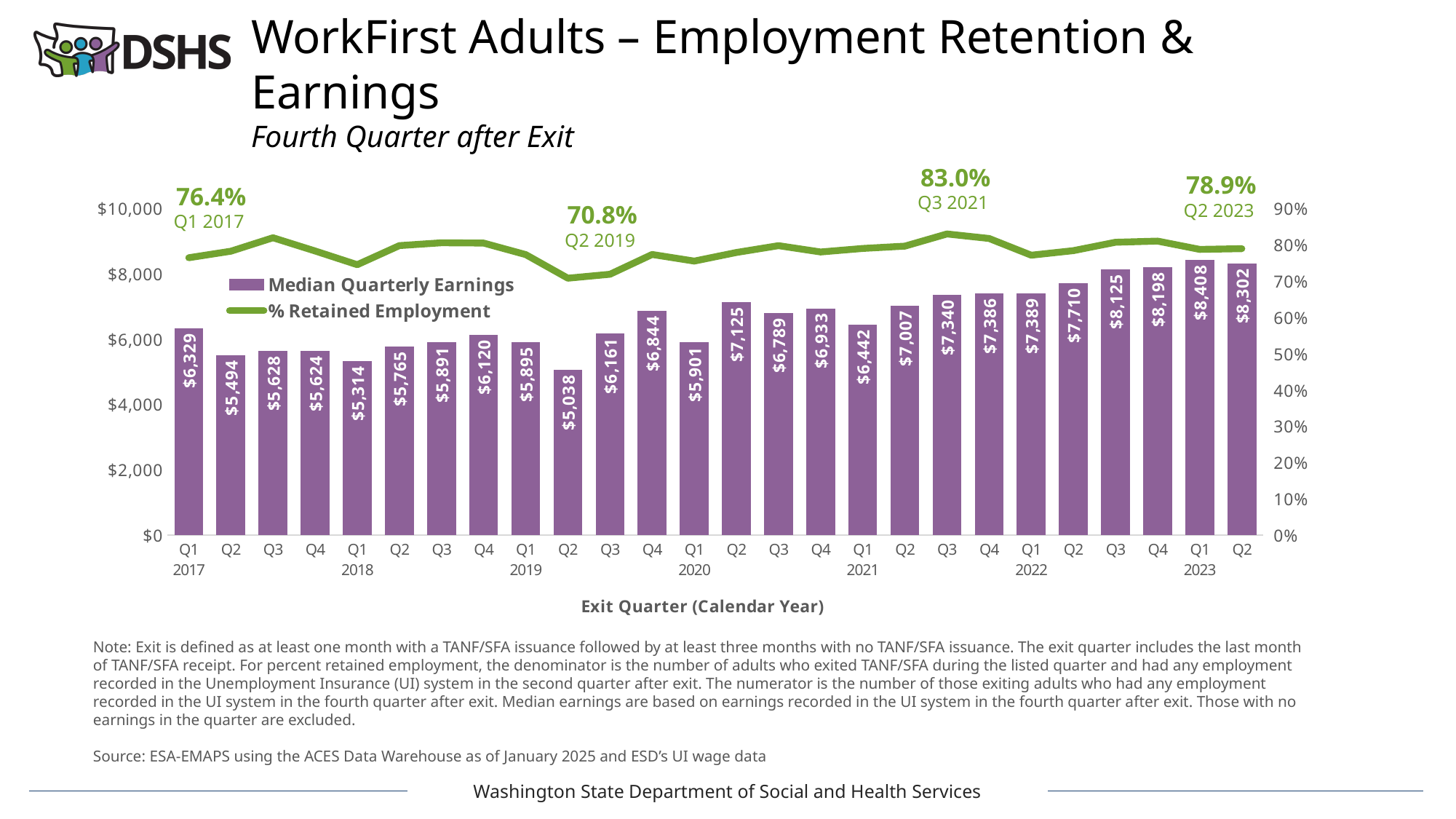
What is the difference between Median Quarterly Earnings for Q1 2023 and Q2 2023? $106 Which exit quarter has the lowest Median Quarterly Earnings? Q2 2019 Which has higher Median Quarterly Earnings, Q4 2020 or Q1 2021? Q4 2020 How many exit quarters are shown on the x axis? 26 Is the % Retained Employment for Q3 2019 greater or less than 80%? less What kind of chart is shown on the slide? Combination bar and line chart How many series does the legend list? 2 What is the Median Quarterly Earnings value for Q1 2017? $6,329 Which exit quarter has the highest Median Quarterly Earnings? Q1 2023 What is the Median Quarterly Earnings value for Q2 2023? $8,302 What is the % Retained Employment for Q3 2021? 83.0% What is the % Retained Employment for Q2 2019? 70.8%